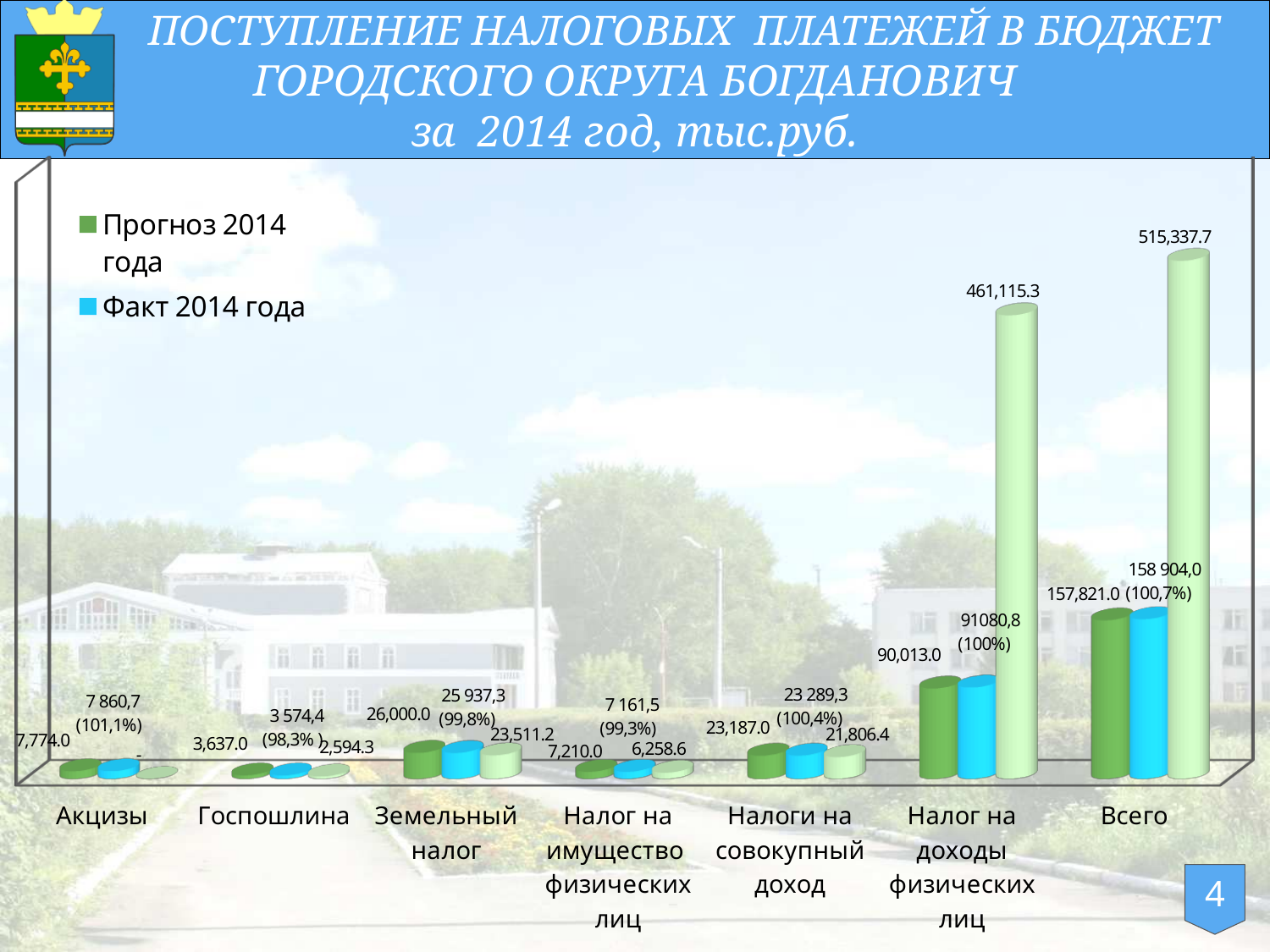
What is the difference between the Прогноз 2014 года values for Всего and Налог на доходы физических лиц? 67,808.0 What is the Факт 2014 года value for Земельный налог? 25 937,3 What is the Прогноз 2014 года value for Акцизы? 7,774.0 Which is larger, the Прогноз 2014 года value for Земельный налог or for Налоги на совокупный доход? Земельный налог What is the Факт 2014 года value for Всего? 158 904,0 Which category has the lowest Прогноз 2014 года value? Госпошлина What kind of chart is shown on the slide? Bar chart How many categories are shown on the x axis? 7 How many series does the legend list? 2 What is the Прогноз 2014 года value for Налог на доходы физических лиц? 90,013.0 What percentage of the forecast is shown next to the Факт 2014 года value for Госпошлина? 98,3% Excluding Всего, which category has the highest Факт 2014 года value? Налог на доходы физических лиц